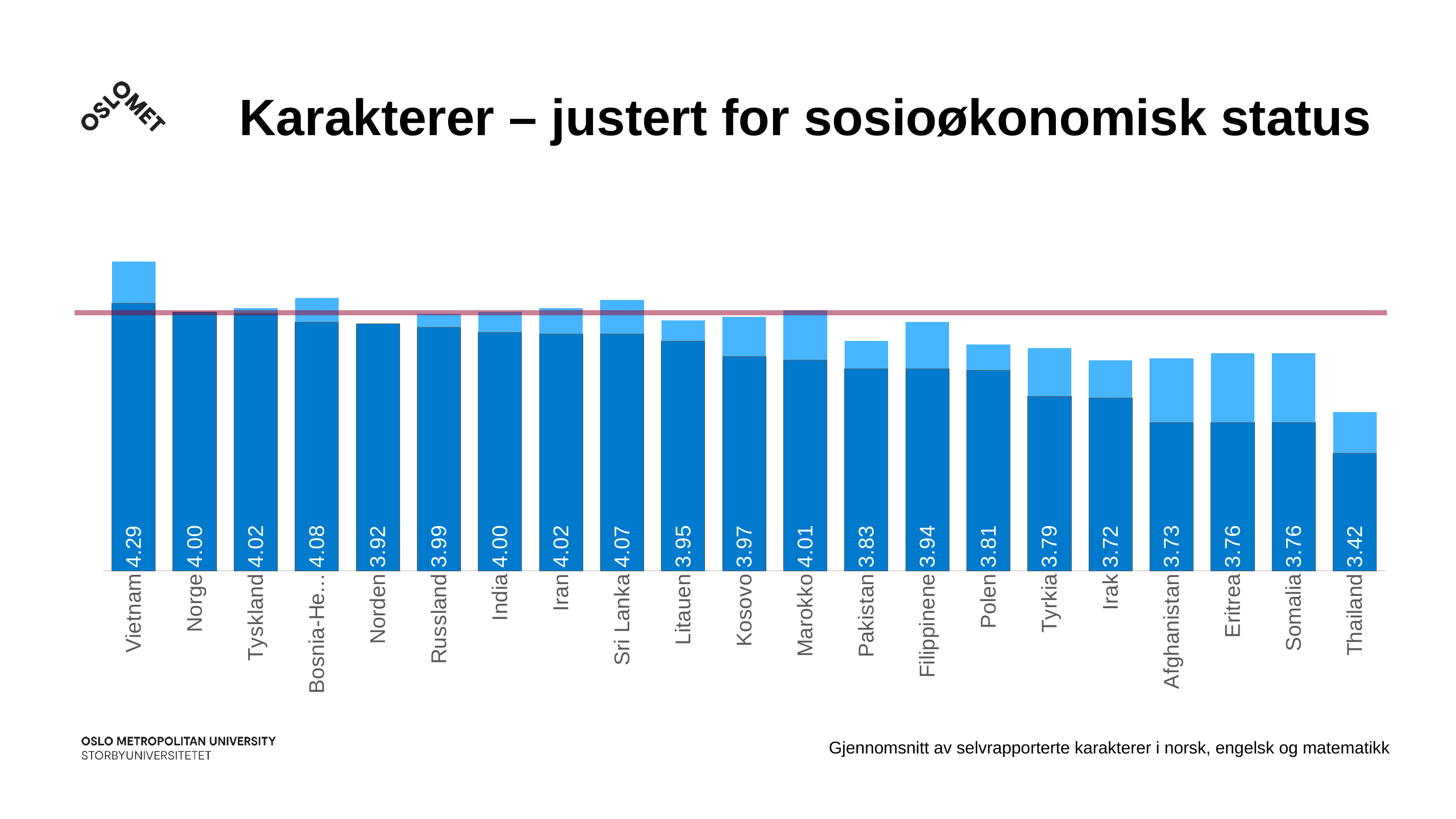
Which has the larger printed value, Pakistan or Filippinene? Filippinene What is the difference between the printed values for Norge and Norden? 0.08 Which country has the lowest printed value? Thailand Which country has the highest printed value? Vietnam What value is printed for Vietnam? 4.29 What is the difference between the printed values for Vietnam and Thailand? 0.87 What value is printed for Irak? 3.72 What value is printed for Norden? 3.92 What is the title of the slide? Karakterer – justert for sosioøkonomisk status What kind of chart is shown on the slide? Bar chart What value is printed for Thailand? 3.42 How many countries/categories are shown on the x axis? 21